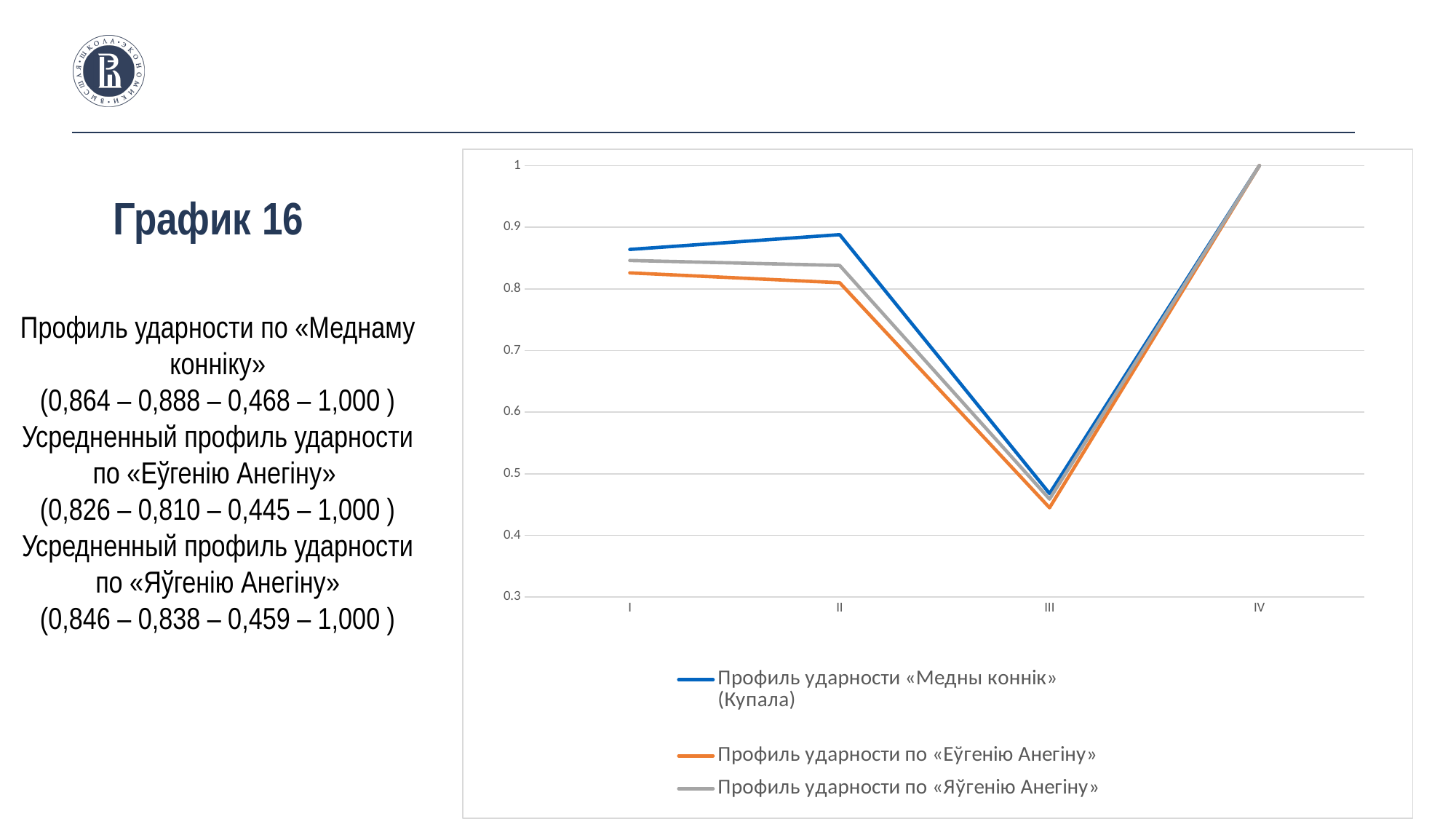
Do the values of the profiles rise or fall from point II to point III? fall What is the value of the «Медны коннік» (Купала) profile at point II? 0,888 How many points are plotted along the x axis for each series? 4 How many series does the legend of the chart list? 3 At which x-axis point do all three profiles reach their highest value? IV What kind of chart is shown on the slide? line chart What colour is the line for the «Еўгенію Анегіну» profile? orange At point I, which is higher: the «Медны коннік» (Купала) profile or the «Еўгенію Анегіну» profile? «Медны коннік» (Купала) What is the difference between the «Медны коннік» (Купала) profile and the «Еўгенію Анегіну» profile at point II? 0,078 Is the value of the «Медны коннік» (Купала) profile at point III greater or less than 0.5? less What is the value of the «Яўгенію Анегіну» profile at point III? 0,459 At which x-axis point does the «Медны коннік» (Купала) profile reach its lowest value? III